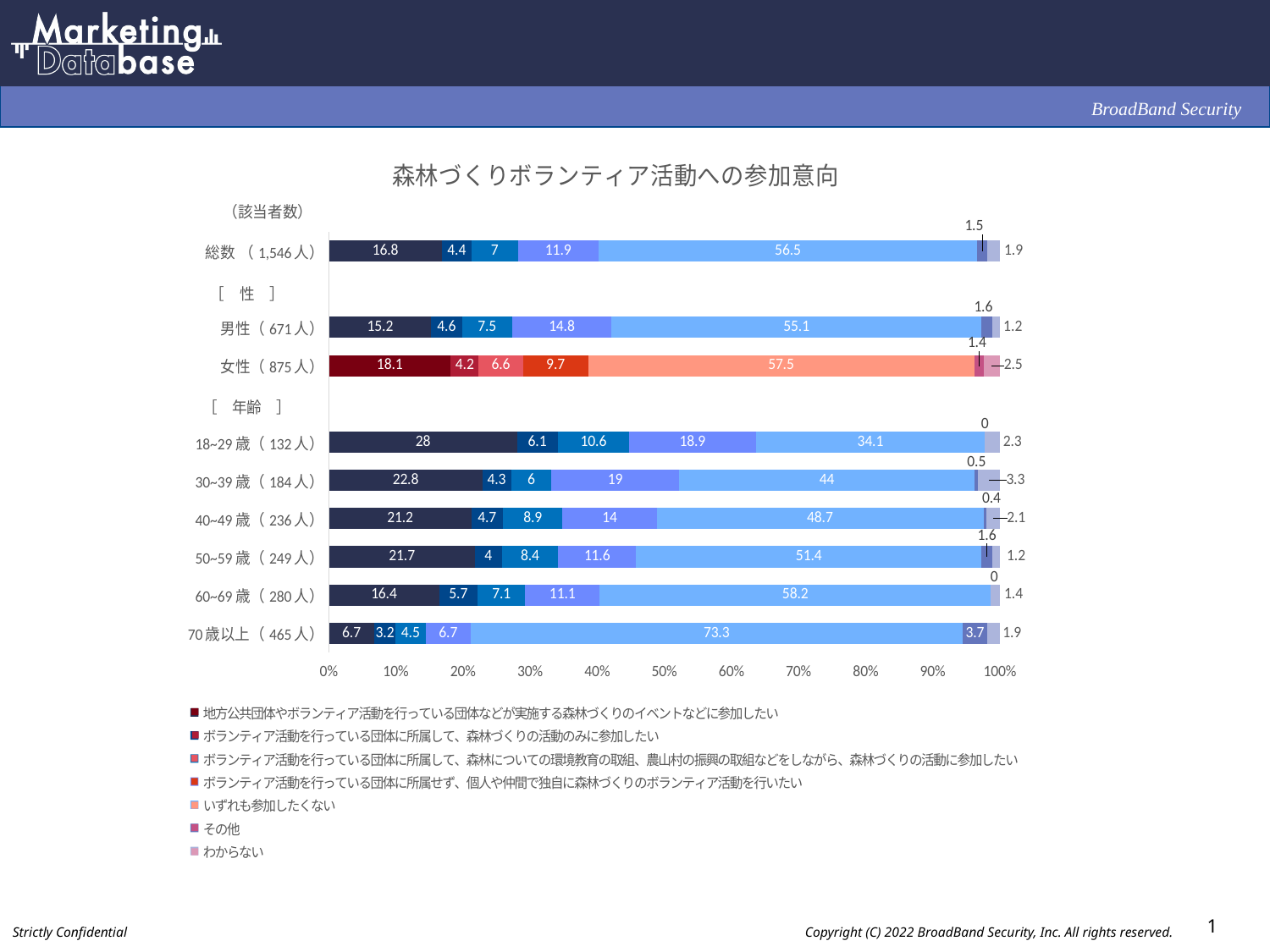
What is the title of the chart? 森林づくりボランティア活動への参加意向 What type of chart is shown on the slide? Stacked bar chart What is the value of その他 for 70歳以上? 3.7 What is the value of the first series (地方公共団体やボランティア活動を行っている団体などが実施する森林づくりのイベントなどに参加したい) for 18~29歳? 28 What is the value of いずれも参加したくない for 総数 (1,546人)? 56.5 Which category has the lowest value for いずれも参加したくない? 18~29歳 (132人) How many series does the legend list? 7 Which category has the highest value for いずれも参加したくない? 70歳以上 (465人) How many category bars are plotted in the chart? 9 What is the value of わからない for 30~39歳? 3.3 Which has a larger value for the first series: 男性 or 女性? 女性 What is the difference between the いずれも参加したくない values for 女性 and 男性? 2.4